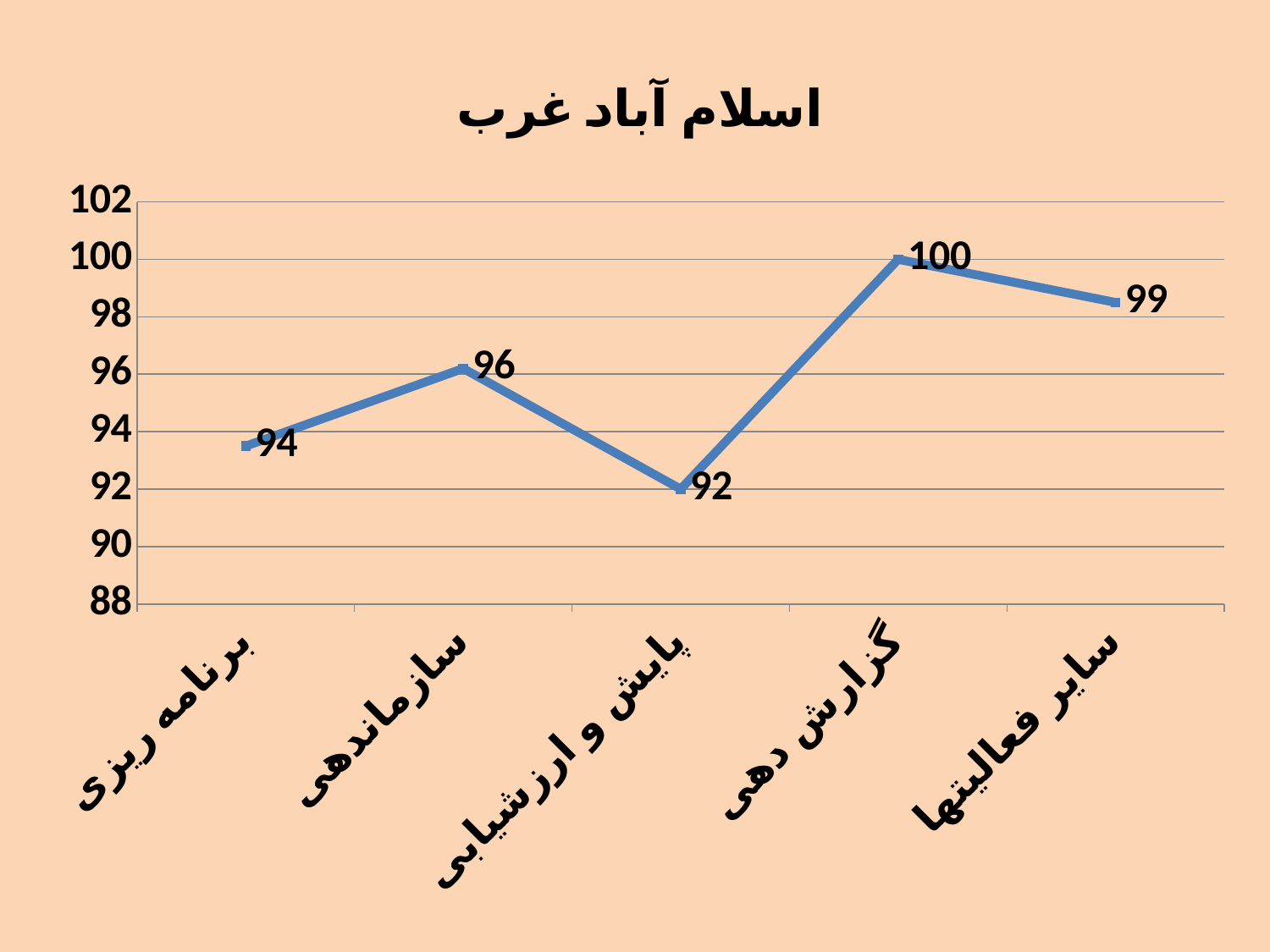
What is the value for پایش و ارزشیابی? 92 What type of chart is shown on the slide? line chart What is the title of the chart? اسلام آباد غرب What is the value for سایر فعالیتها? 99 How many categories are plotted on the x axis? 5 What is the value for گزارش دهی? 100 What is the value for برنامه ریزی? 94 Which category has the lowest value? پایش و ارزشیابی What is the value for سازماندهی? 96 What is the difference between the values for گزارش دهی and پایش و ارزشیابی? 8 Which category has the highest value? گزارش دهی Which is larger, the value for سازماندهی or the value for برنامه ریزی? سازماندهی